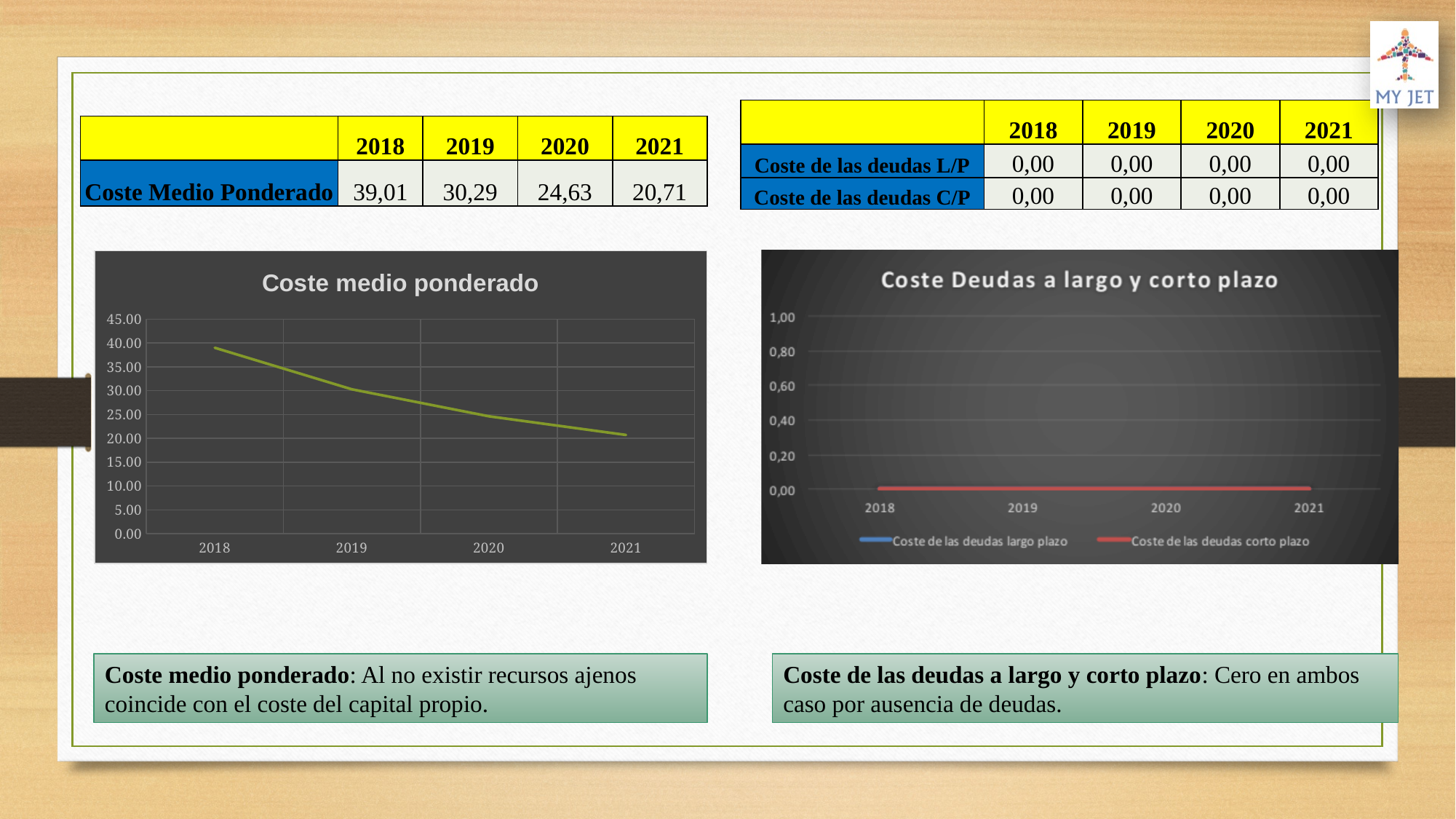
How many years are plotted on the x axis of the "Coste medio ponderado" chart? 4 According to the slide, what is the Coste Medio Ponderado value for 2019? 30,29 How many series does the legend of the "Coste Deudas a largo y corto plazo" chart list? 2 In the "Coste medio ponderado" chart, which year has the lowest value? 2021 In the "Coste medio ponderado" chart, is the value for 2021 greater or less than 25.00? less In the "Coste Deudas a largo y corto plazo" chart, what is the value of Coste de las deudas corto plazo in 2020? 0,00 In the "Coste medio ponderado" chart, is the value for 2018 greater or less than 35.00? greater What colour is the line for Coste de las deudas corto plazo in the "Coste Deudas a largo y corto plazo" chart? red In the "Coste medio ponderado" chart, do the values rise or fall from 2018 to 2021? fall In the "Coste medio ponderado" chart, which year has the highest value? 2018 According to the slide, what is the Coste Medio Ponderado value for 2020? 24,63 What kind of chart is the "Coste medio ponderado" chart? line chart